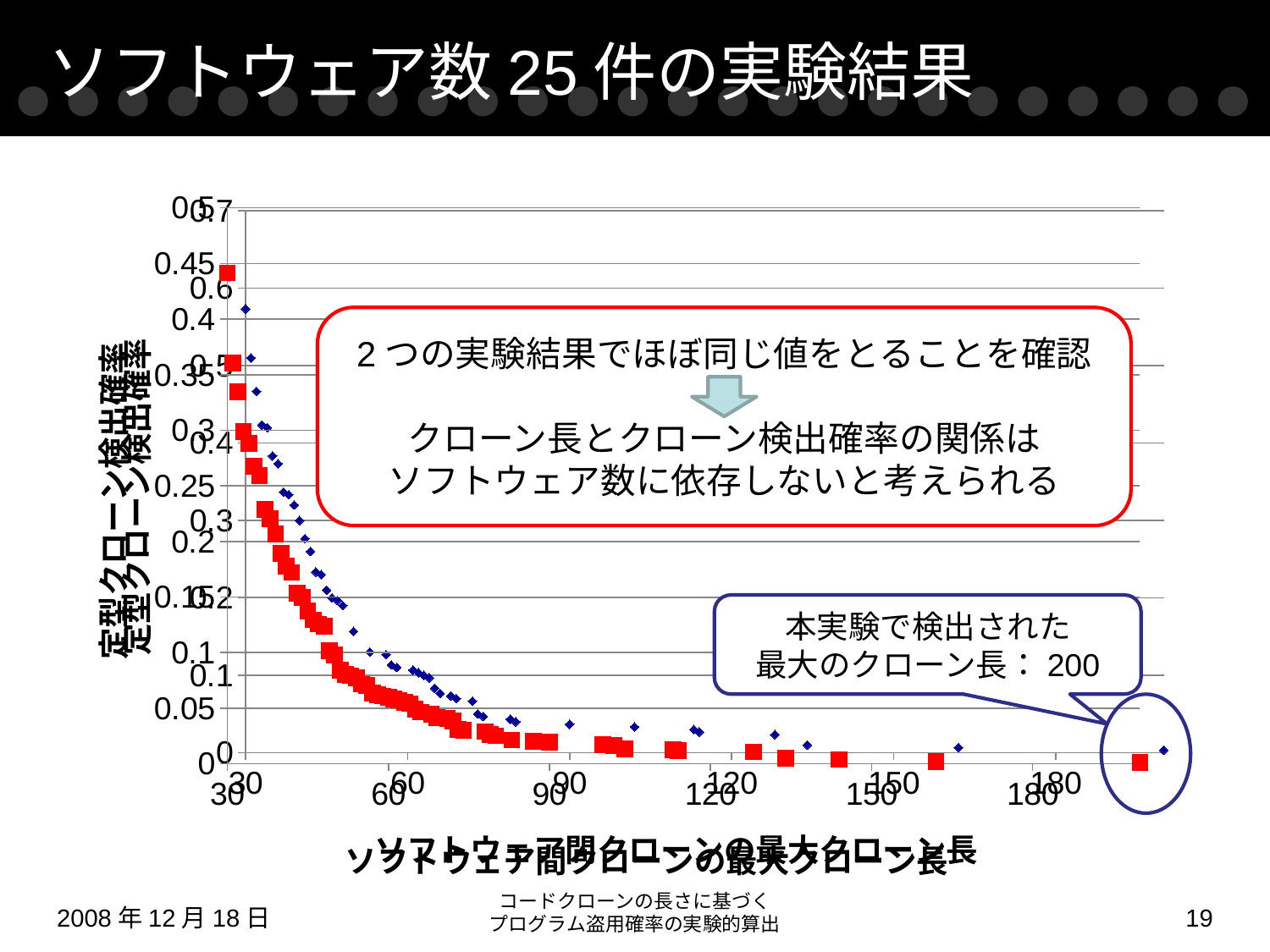
Is the value of the leftmost red square (at x = 30) greater or less than 0.4? greater Is the value of the rightmost blue diamond (near x = 200) greater or less than 0.1? less Do the plotted values rise or fall as the maximum clone length on the x axis increases? fall Is the value of the red square at x = 160 greater or less than 0.1? less What kind of chart is shown on the slide? scatter chart What colours are the two marker series plotted on the chart? red and blue According to the callout on the chart, what is the maximum clone length detected in this experiment? 200